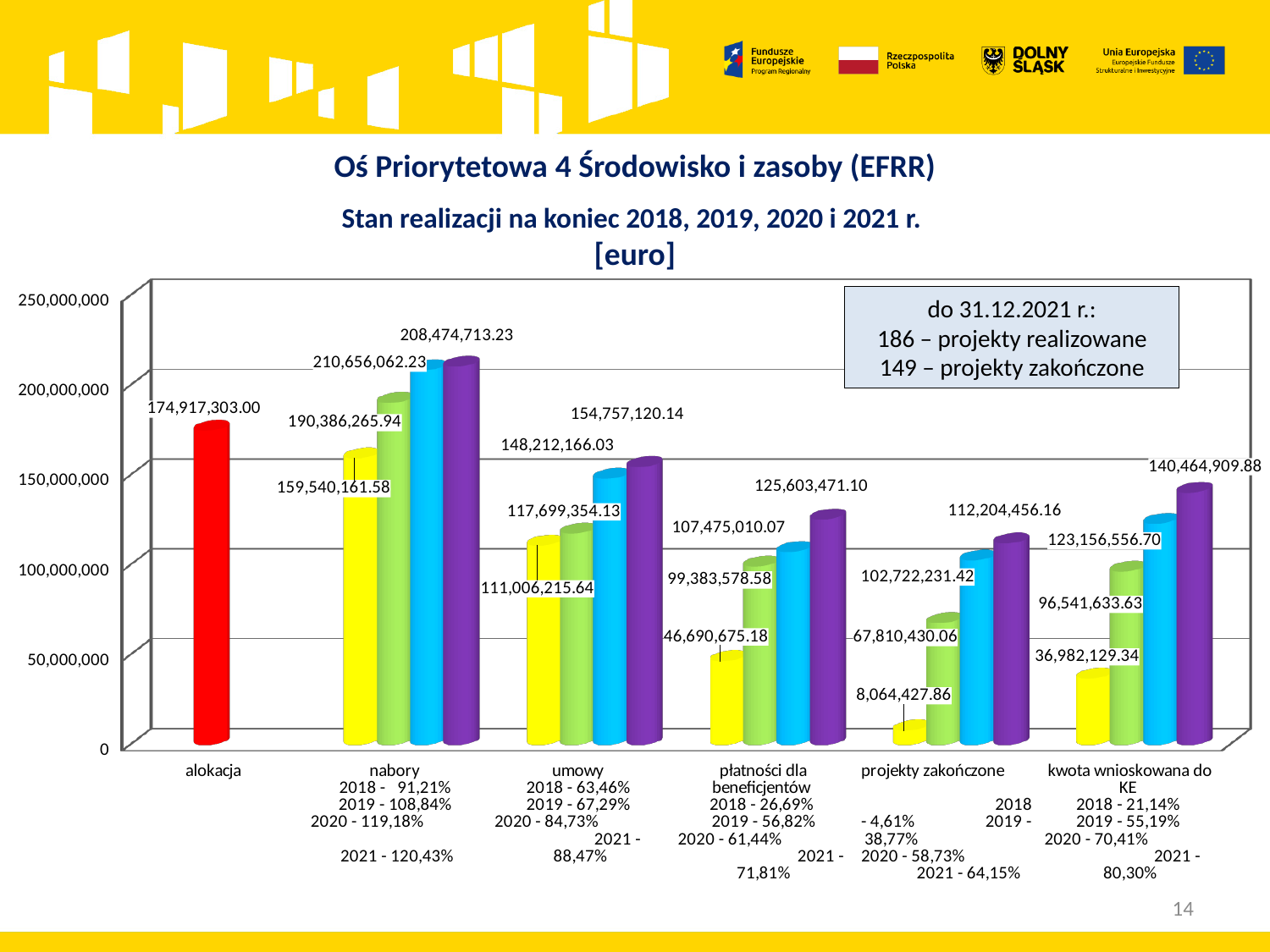
What is the difference between the two tallest bars in the projekty zakończone group (112,204,456.16 and 102,722,231.42)? 9,482,224.74 How many categories are shown on the x axis? 6 What is the value of the smallest bar in the projekty zakończone group? 8,064,427.86 What is the difference between the tallest nabory bar (210,656,062.23) and the alokacja bar (174,917,303.00)? 35,738,759.23 What kind of chart is shown on the slide? bar chart According to the text box on the chart, how many projects were being realised (projekty realizowane) as of 31.12.2021? 186 What is the value of the alokacja bar? 174,917,303.00 Which is larger: the tallest bar in the umowy group or the tallest bar in the płatności dla beneficjentów group? umowy Is the value of the alokacja bar greater or less than 150,000,000? greater Within the kwota wnioskowana do KE group, do the bars rise or fall from left to right? rise What is the value of the tallest bar in the kwota wnioskowana do KE group? 140,464,909.88 What is the value of the tallest bar in the nabory group? 210,656,062.23